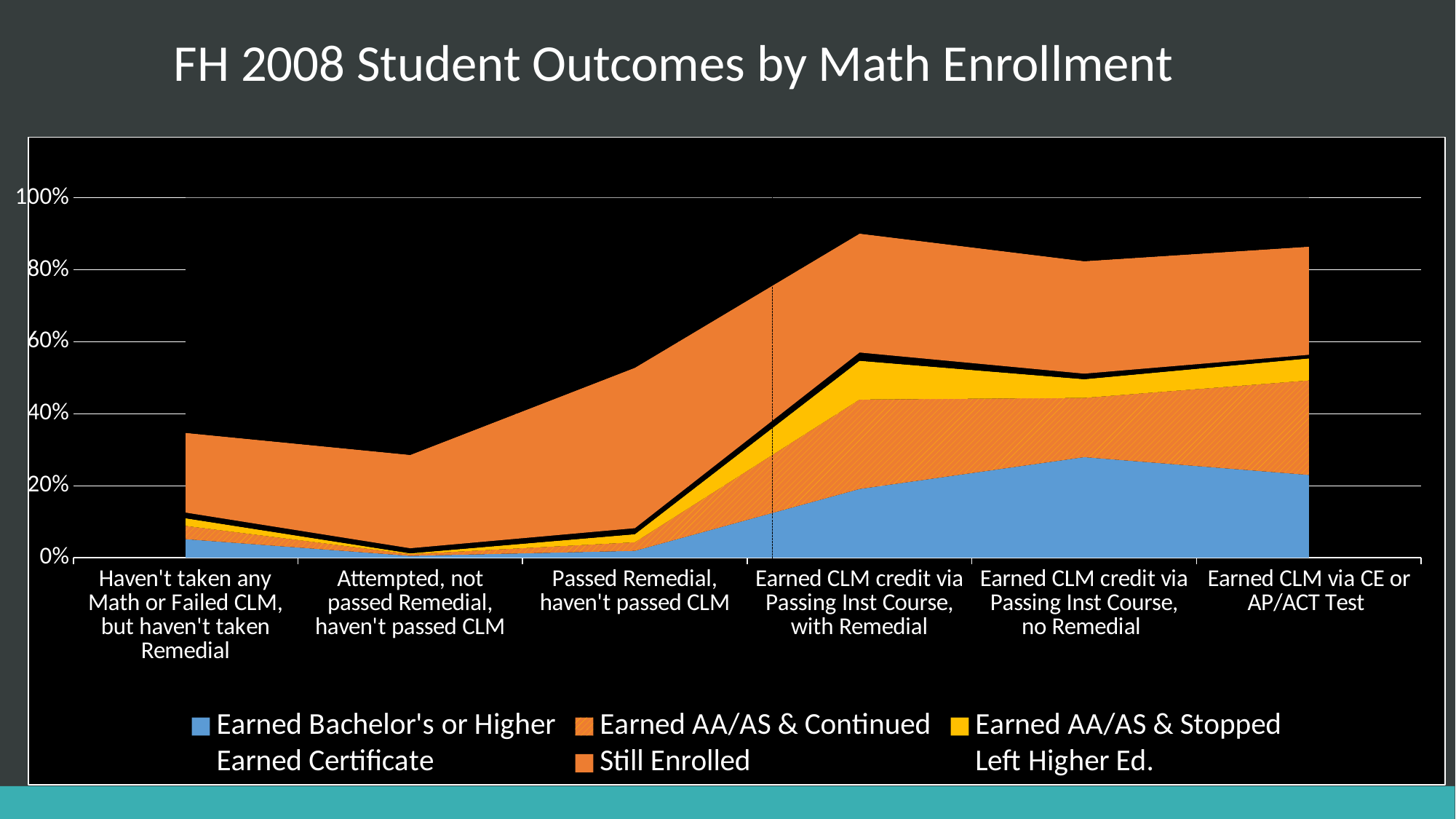
Is the top of the stacked area (through 'Still Enrolled') for 'Earned CLM credit via Passing Inst Course, with Remedial' greater or less than 80%? greater Is the 'Earned Bachelor's or Higher' value for 'Haven't taken any Math or Failed CLM, but haven't taken Remedial' greater or less than 20%? less How many series does the legend list? 6 Which has the larger 'Earned Bachelor's or Higher' value: 'Passed Remedial, haven't passed CLM' or 'Earned CLM via CE or AP/ACT Test'? Earned CLM via CE or AP/ACT Test What is the title of the chart? FH 2008 Student Outcomes by Math Enrollment How many math enrollment categories are shown along the x axis? 6 Which colour represents the 'Earned Bachelor's or Higher' series? Blue Which category has the highest 'Earned Bachelor's or Higher' value? Earned CLM credit via Passing Inst Course, no Remedial Is the 'Earned Bachelor's or Higher' value for 'Earned CLM credit via Passing Inst Course, no Remedial' greater or less than 20%? greater Which category has the lowest 'Earned Bachelor's or Higher' value? Attempted, not passed Remedial, haven't passed CLM What kind of chart is shown on the slide? Stacked area chart